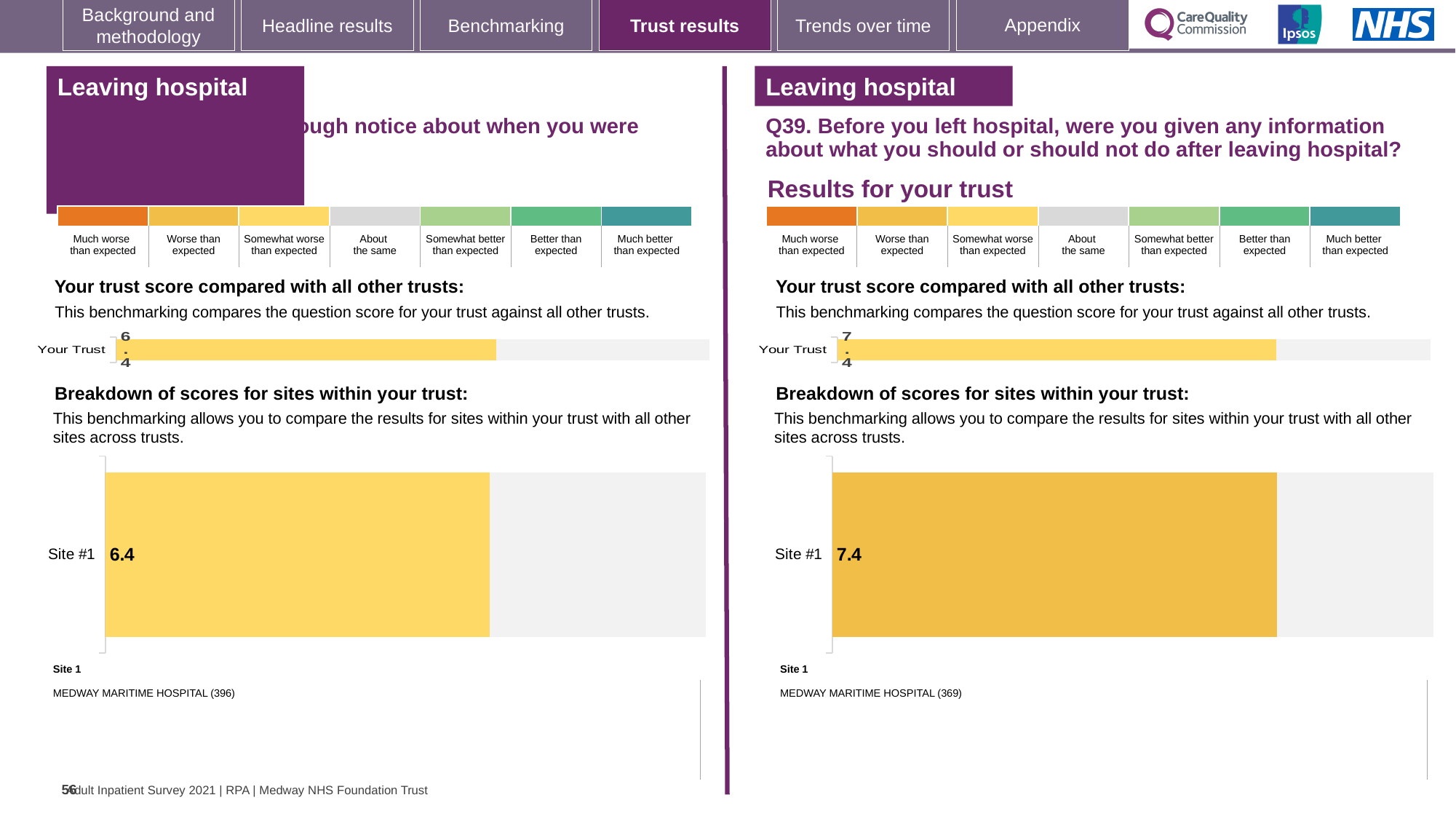
On the left-hand side of the slide, what is the score shown for Site #1? 6.4 How many sites are shown in the 'Breakdown of scores for sites within your trust' chart on the left-hand side of the slide? 1 What type of chart is used to show the Site #1 score on the right-hand side of the slide (Q39)? Bar chart What is the difference between the Site #1 score on the right-hand side (Q39) and the Site #1 score on the left-hand side of the slide? 1.0 On the left-hand side of the slide, what is the score shown for Your Trust? 6.4 On the right-hand side of the slide (Q39), what is the score shown for Your Trust? 7.4 Which is larger: the Site #1 score on the left-hand side of the slide or the Site #1 score on the right-hand side (Q39)? Right-hand side (Q39) How many sites are shown in the 'Breakdown of scores for sites within your trust' chart on the right-hand side of the slide (Q39)? 1 On the right-hand side of the slide (Q39), what is the score shown for Site #1? 7.4 On the left-hand side of the slide, which site name is listed as Site 1? MEDWAY MARITIME HOSPITAL (396) On the right-hand side of the slide (Q39), which site name is listed as Site 1? MEDWAY MARITIME HOSPITAL (369) Is the Site #1 score on the right-hand side of the slide (Q39) greater or less than 7? greater